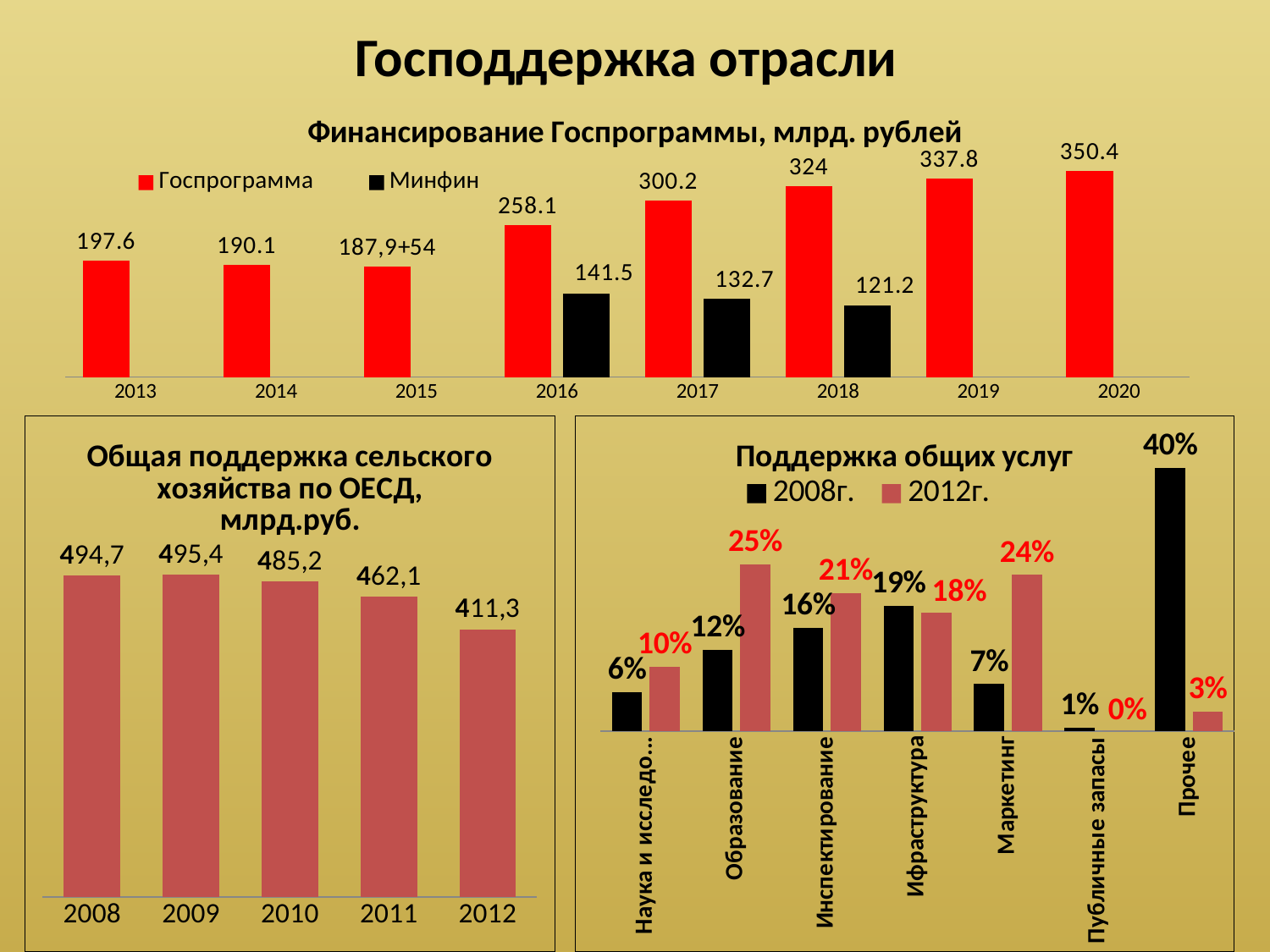
In the chart 'Финансирование Госпрограммы, млрд. рублей', what is the Минфин value for 2018? 121.2 In the chart 'Финансирование Госпрограммы, млрд. рублей', which year has the highest Госпрограмма value? 2020 In the chart 'Финансирование Госпрограммы, млрд. рублей', what is the Госпрограмма value for 2017? 300.2 In the chart 'Общая поддержка сельского хозяйства по ОЕСД, млрд.руб.', which year has the lowest value? 2012 In the chart 'Поддержка общих услуг', what is the 2012г. value for Маркетинг? 24% In the chart 'Общая поддержка сельского хозяйства по ОЕСД, млрд.руб.', how many years are shown? 5 In the chart 'Финансирование Госпрограммы, млрд. рублей', do the Госпрограмма values rise or fall from 2016 to 2020? rise In the chart 'Общая поддержка сельского хозяйства по ОЕСД, млрд.руб.', what is the value for 2011? 462,1 In the chart 'Поддержка общих услуг', which is larger for Образование: the 2008г. value or the 2012г. value? 2012г. In the chart 'Финансирование Госпрограммы, млрд. рублей', how many series does the legend list? 2 In the chart 'Финансирование Госпрограммы, млрд. рублей', what is the difference between the Госпрограмма and Минфин values for 2016? 116.6 In the chart 'Поддержка общих услуг', which category has the highest 2008г. value? Прочее